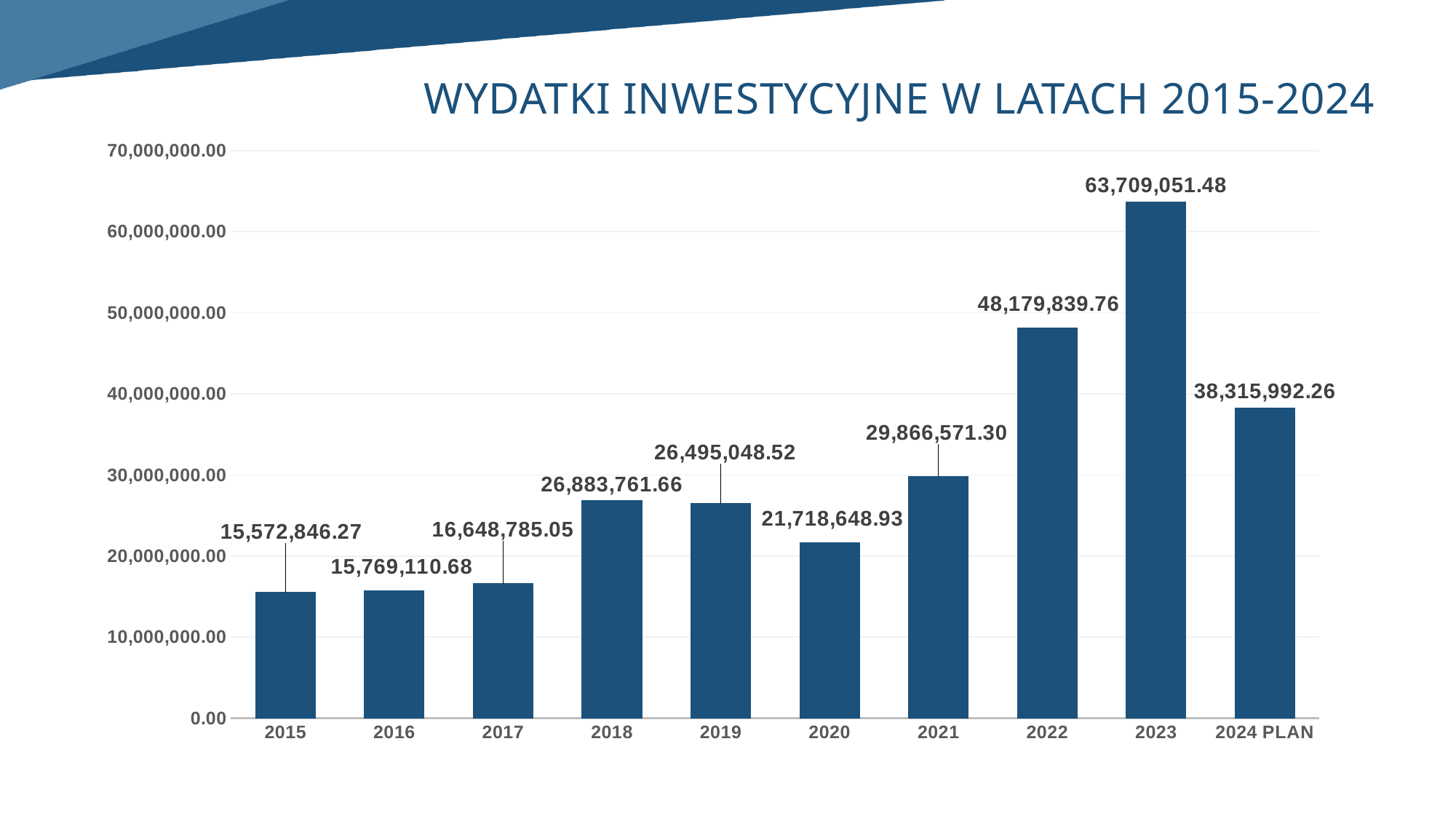
Is the value for 2021 greater or less than 30,000,000.00? less Which is larger, the value for 2022 or the value for 2024 PLAN? 2022 What kind of chart is shown on the slide? bar chart What is the difference between the values for 2023 and 2022? 15,529,211.72 How many years are shown on the x axis? 10 What is the value for 2023? 63,709,051.48 Which year has the highest value? 2023 What is the value for 2020? 21,718,648.93 Which year has the lowest value? 2015 What is the value for 2024 PLAN? 38,315,992.26 What is the difference between the values for 2018 and 2017? 10,234,976.61 What is the title of the chart? WYDATKI INWESTYCYJNE W LATACH 2015-2024